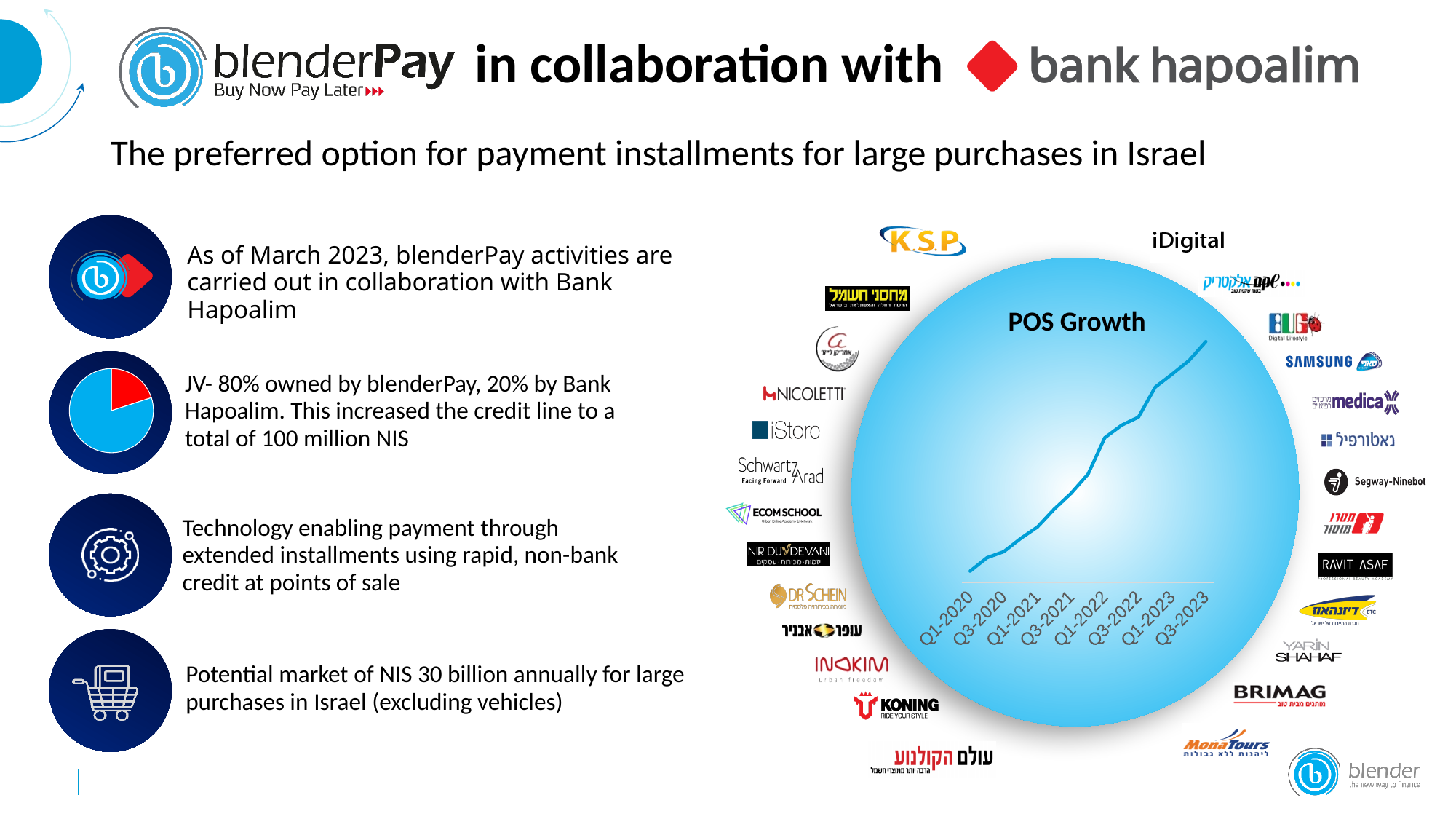
What is the first quarter label on the x axis of the POS Growth chart? Q1-2020 How many quarter labels are shown on the x axis of the POS Growth chart? 8 Which quarter has the highest value in the POS Growth chart? Q3-2023 Do the values in the POS Growth chart rise or fall from Q1-2020 to Q3-2023? rise In the POS Growth chart, which is larger: the value for Q1-2022 or the value for Q3-2020? Q1-2022 In the POS Growth chart, which is larger: the value for Q3-2021 or the value for Q1-2023? Q1-2023 How many lines are plotted in the POS Growth chart? 1 Which quarter has the lowest value in the POS Growth chart? Q1-2020 What type of chart is the POS Growth chart? line chart What is the title of the chart inside the blue circle? POS Growth